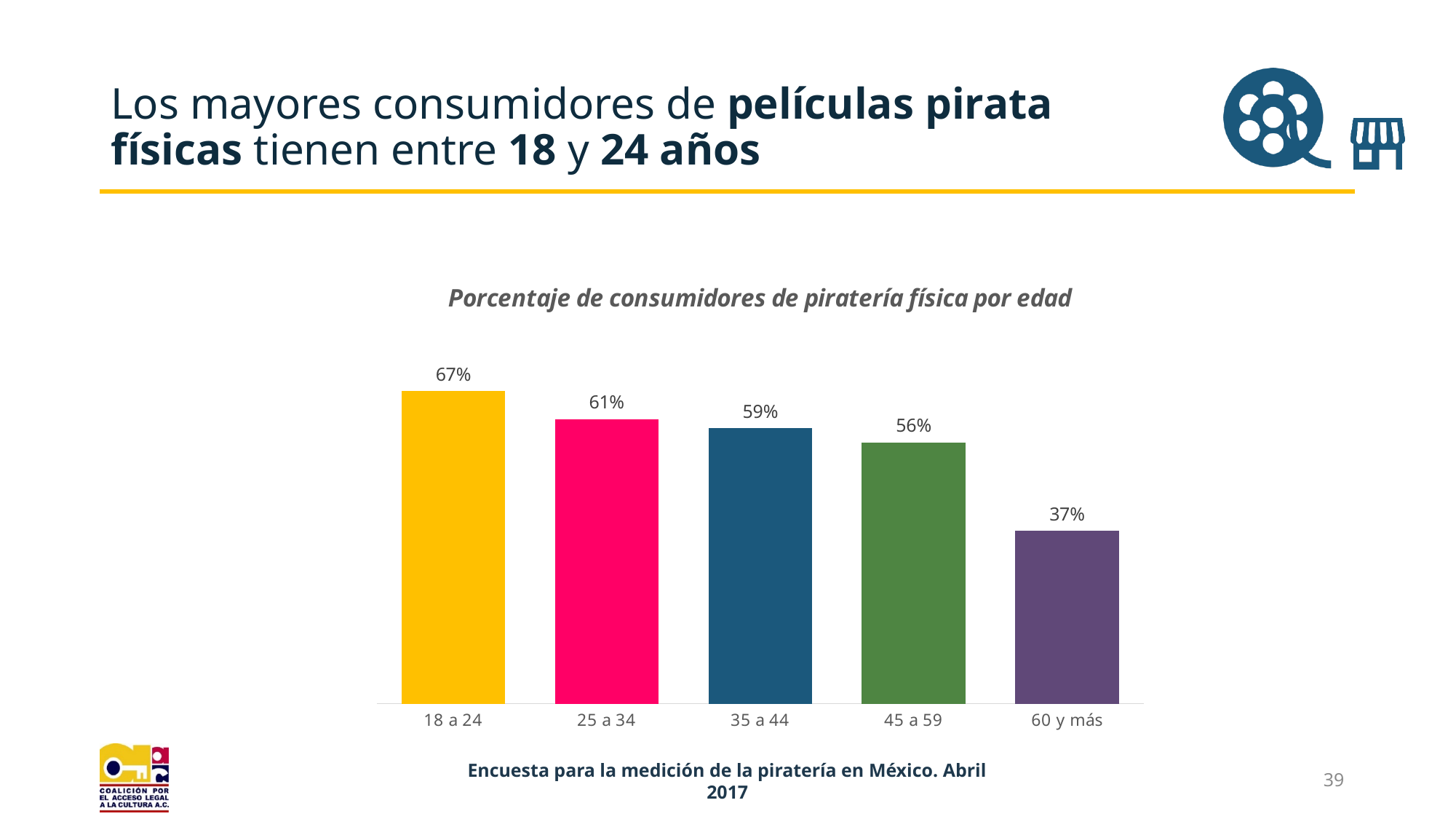
What is the value for the 60 y más age group? 37% What is the value for the 35 a 44 age group? 59% What kind of chart is shown on the slide? Bar chart What is the difference between the values for 25 a 34 and 45 a 59? 5% How many age groups are shown in the chart? 5 Which age group has the highest percentage? 18 a 24 What is the title of the chart? Porcentaje de consumidores de piratería física por edad Do the values rise or fall from left to right across the age groups? Fall Which is larger, the value for 25 a 34 or the value for 45 a 59? 25 a 34 What is the value for the 18 a 24 age group? 67% What is the difference between the values for 18 a 24 and 60 y más? 30% Which age group has the lowest percentage? 60 y más